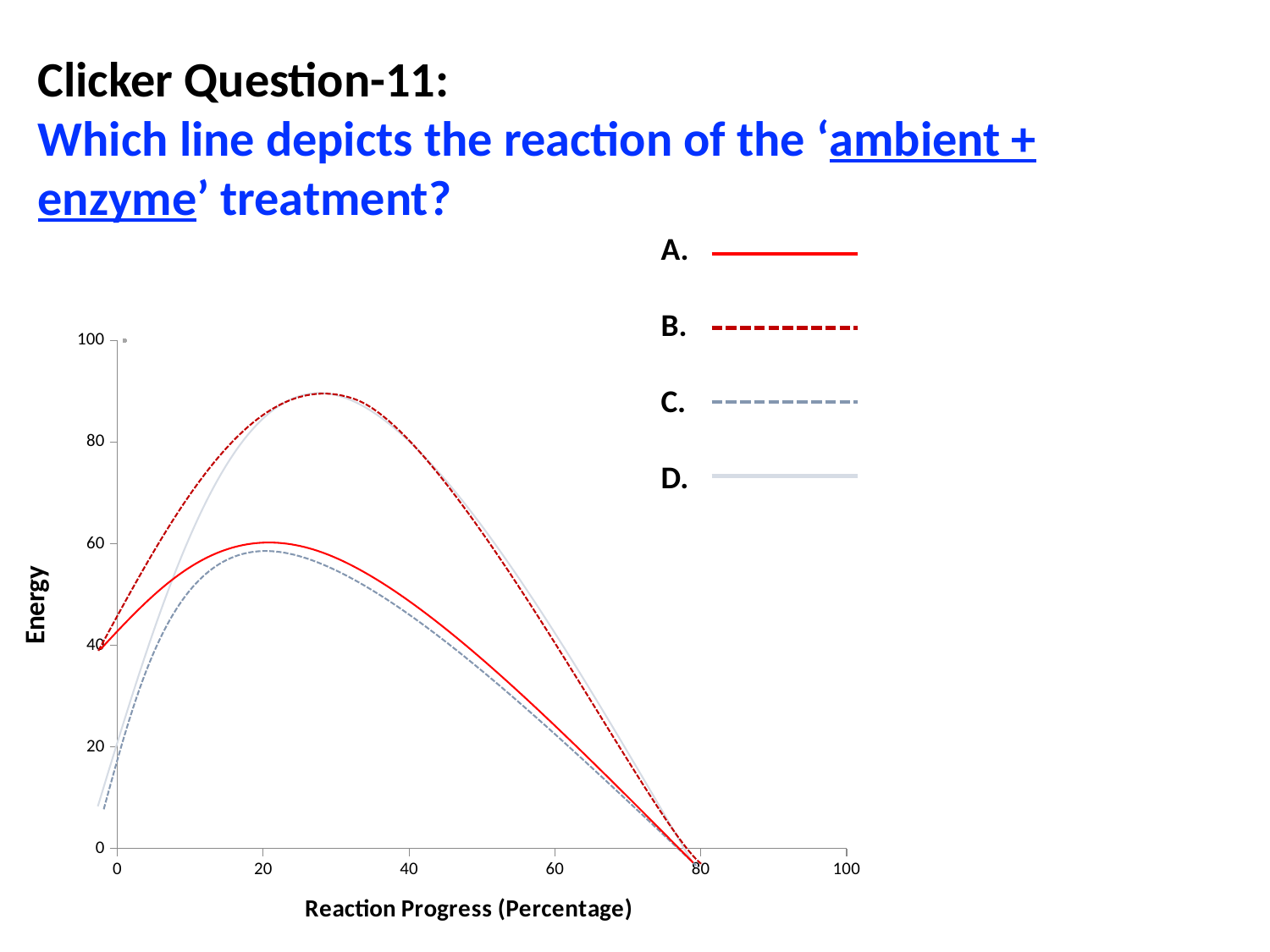
Do the values of line B rise or fall between reaction progress 0 and 20? rise Which line reaches a higher peak, line A or line B? B Do the values of line A rise or fall between reaction progress 40 and 80? fall What is the title of the x axis? Reaction Progress (Percentage) Is the peak value of line C greater or less than 40? greater Is the peak value of line B greater or less than 80? greater What is the title of the y axis? Energy Is the peak value of line A greater or less than 80? less How many lines does the legend list? 4 Which line reaches a higher peak, line C or line D? D What kind of chart is shown on the slide? line chart